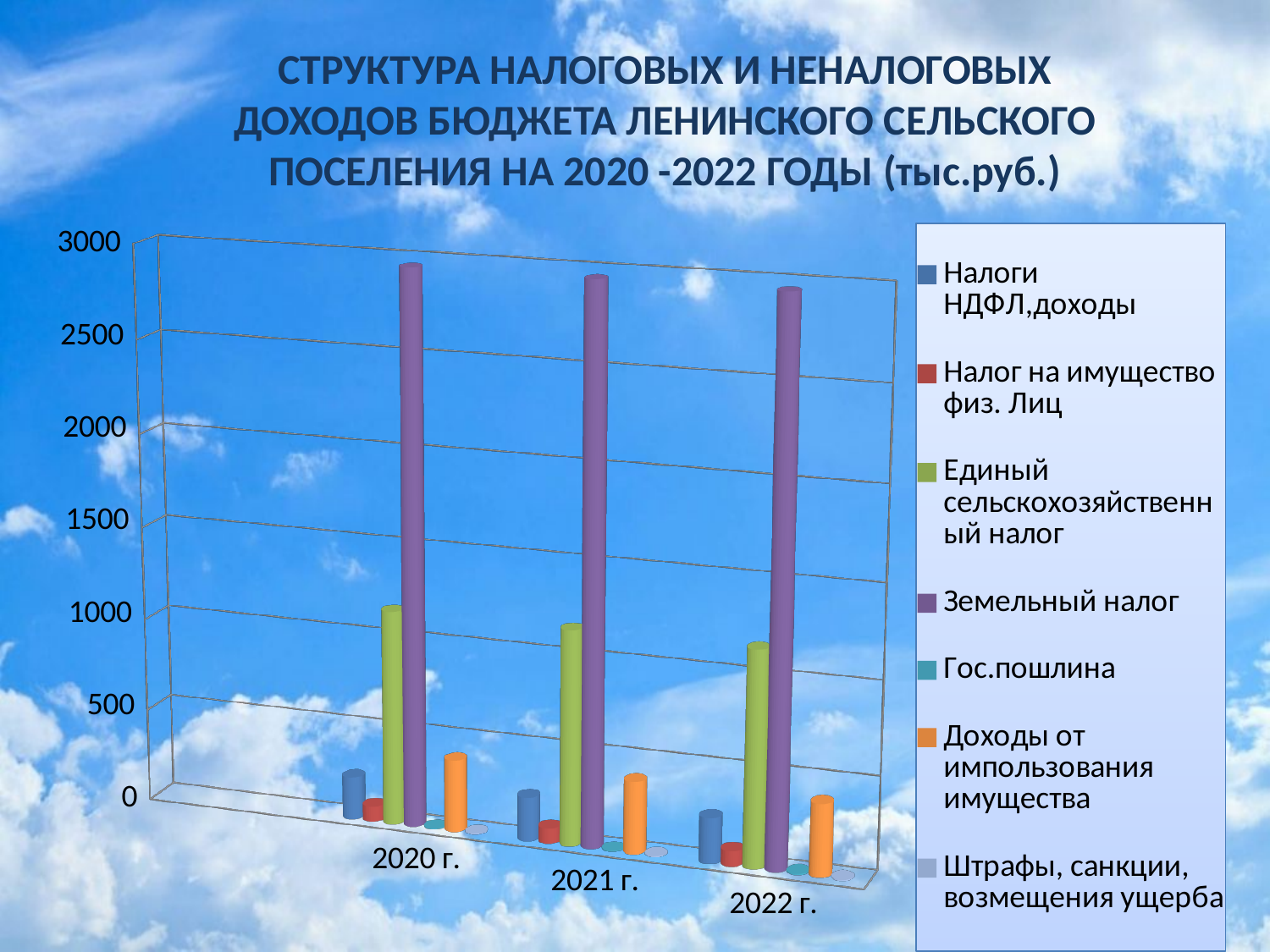
In 2021 г., which is larger: Единый сельскохозяйственный налог or Доходы от импользования имущества? Единый сельскохозяйственный налог How many series does the chart legend list? 7 Is the value for Доходы от импользования имущества in 2020 г. greater or less than 500? less What colour represents Земельный налог in the chart legend? Purple How many year categories are shown on the x axis of the chart? 3 Which series has the highest value in 2022 г.? Земельный налог What kind of chart is shown on the slide? Bar chart Is the value for Единый сельскохозяйственный налог in 2020 г. greater or less than 1500? less Is the value for Земельный налог in 2020 г. greater or less than 2500? greater Which series has the highest value in 2020 г.? Земельный налог